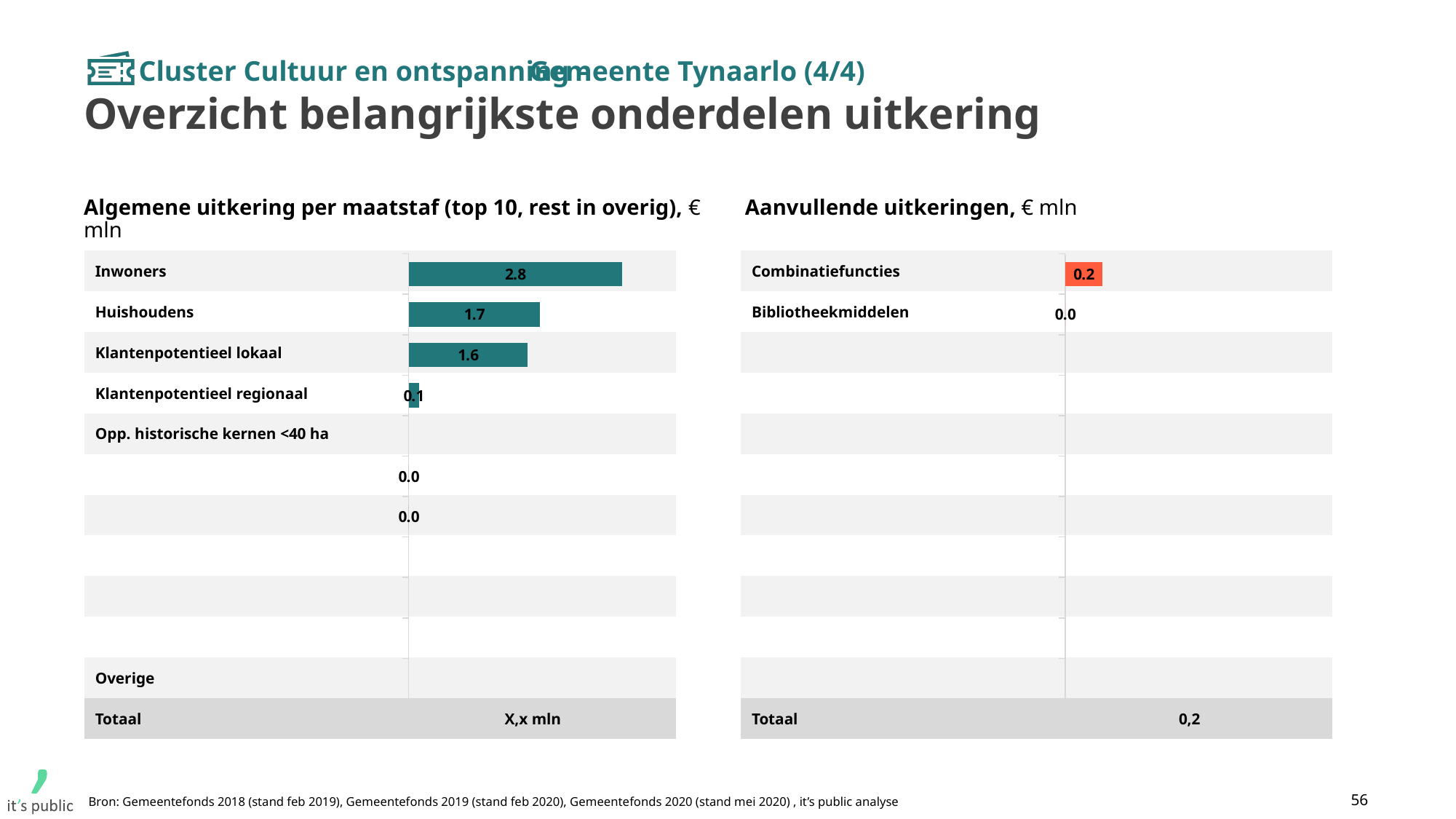
In the 'Algemene uitkering per maatstaf' chart, what is the difference between Inwoners and Huishoudens? 1.1 In the 'Aanvullende uitkeringen' chart, what is the Totaal shown? 0,2 In the 'Algemene uitkering per maatstaf' chart, what is the value for Klantenpotentieel lokaal? 1.6 What kind of chart is the 'Algemene uitkering per maatstaf' chart? Bar chart What unit is stated in the title of the 'Aanvullende uitkeringen' chart? € mln In the 'Algemene uitkering per maatstaf' chart, which is larger: Inwoners or Klantenpotentieel lokaal? Inwoners In the 'Aanvullende uitkeringen' chart, what is the value for Combinatiefuncties? 0.2 In the 'Algemene uitkering per maatstaf' chart, what is the value for Inwoners? 2.8 In the 'Aanvullende uitkeringen' chart, what is the value for Bibliotheekmiddelen? 0.0 In the 'Algemene uitkering per maatstaf' chart, what is the value for Klantenpotentieel regionaal? 0.1 In the 'Algemene uitkering per maatstaf' chart, which labelled category has the highest value? Inwoners In the 'Algemene uitkering per maatstaf' chart, what is the value for Huishoudens? 1.7